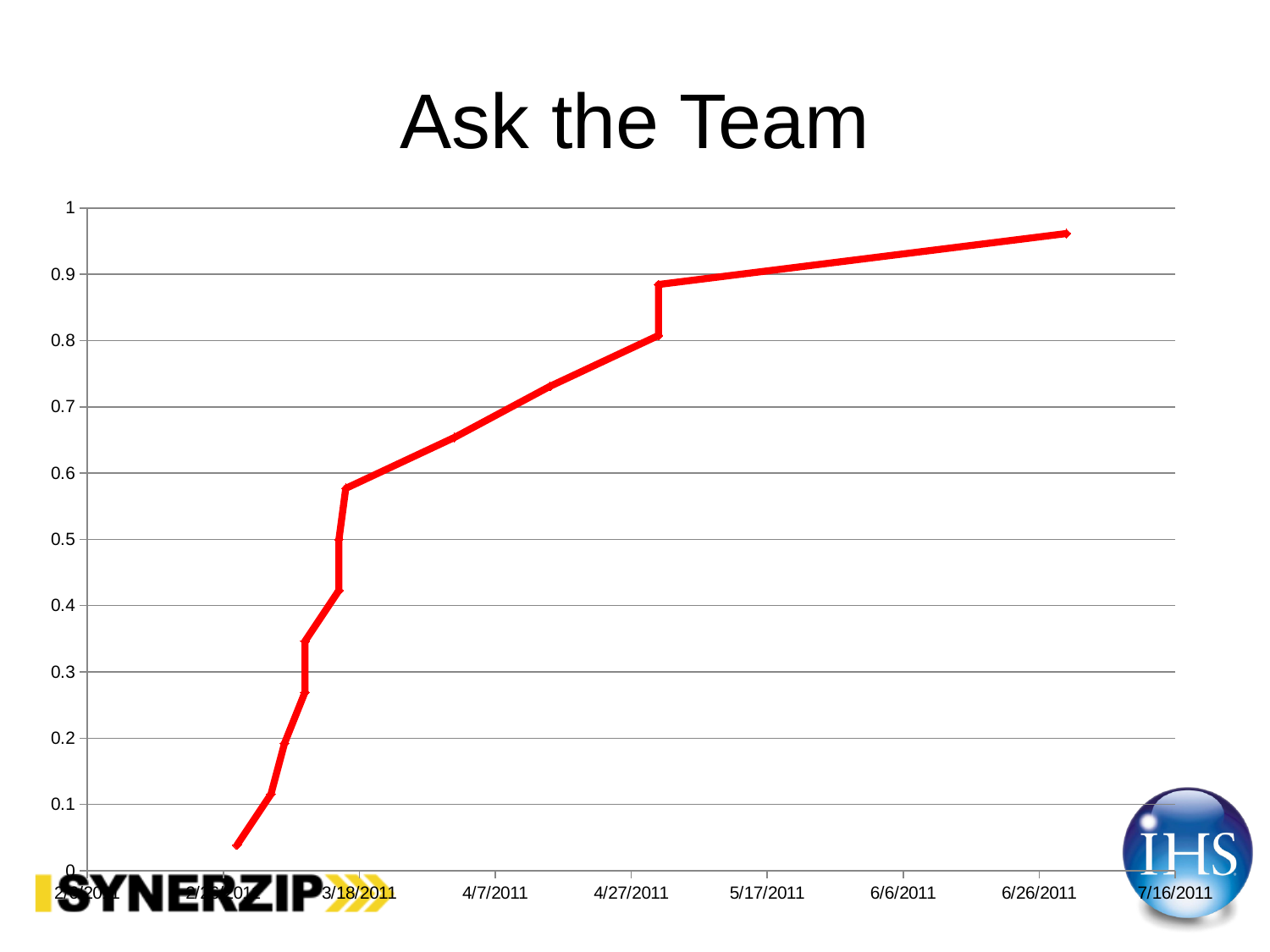
What is the maximum value shown on the y axis? 1 What kind of chart is shown on the slide? line chart Is the line higher at 6/6/2011 or at 4/7/2011? 6/6/2011 Is the value of the line at 3/18/2011 greater or less than 0.7? less What is the title of the chart? Ask the Team Is the line higher at 4/27/2011 or at 3/18/2011? 4/27/2011 What colour is the plotted line? red Is the lowest value plotted on the line greater or less than 0.1? less How many lines are plotted on the chart? 1 Is the highest value plotted on the line greater or less than 0.9? greater Do the values rise or fall along the x axis from 2/6/2011 to 7/16/2011? rise